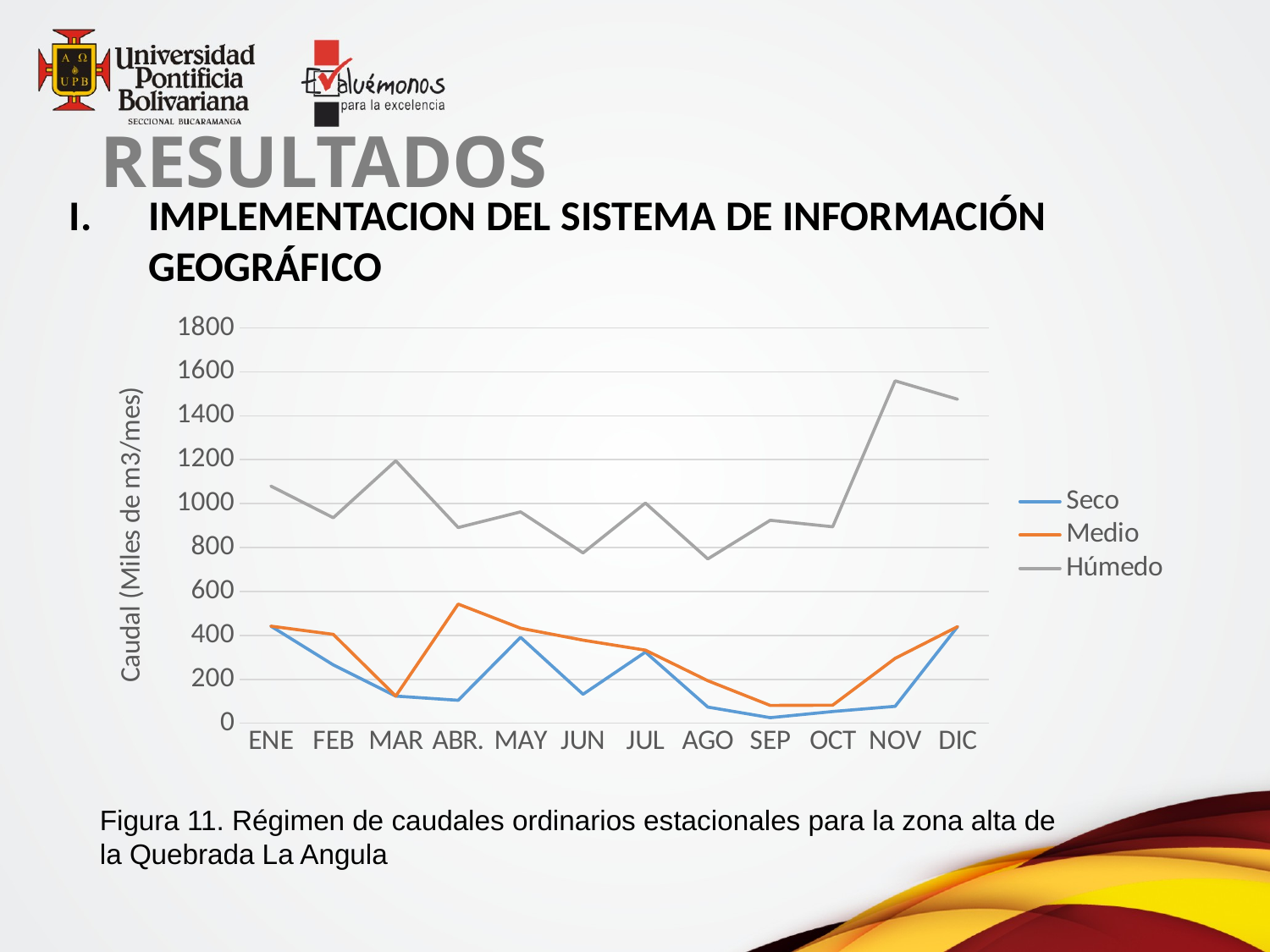
What kind of chart is shown on the slide? Line chart Which series has the larger value in FEB, Seco or Medio? Medio In which month does the Medio series reach its highest value? ABR. What is the label of the vertical axis? Caudal (Miles de m3/mes) Which series are listed in the legend? Seco, Medio, Húmedo How many months are shown along the x axis? 12 Does the Húmedo series rise or fall from OCT to NOV? Rise Is the Húmedo value for AGO greater or less than 800? less In which month does the Seco series reach its lowest value? SEP Is the Húmedo value for NOV greater or less than 1400? greater In which month does the Húmedo series reach its highest value? NOV How many series does the legend list? 3